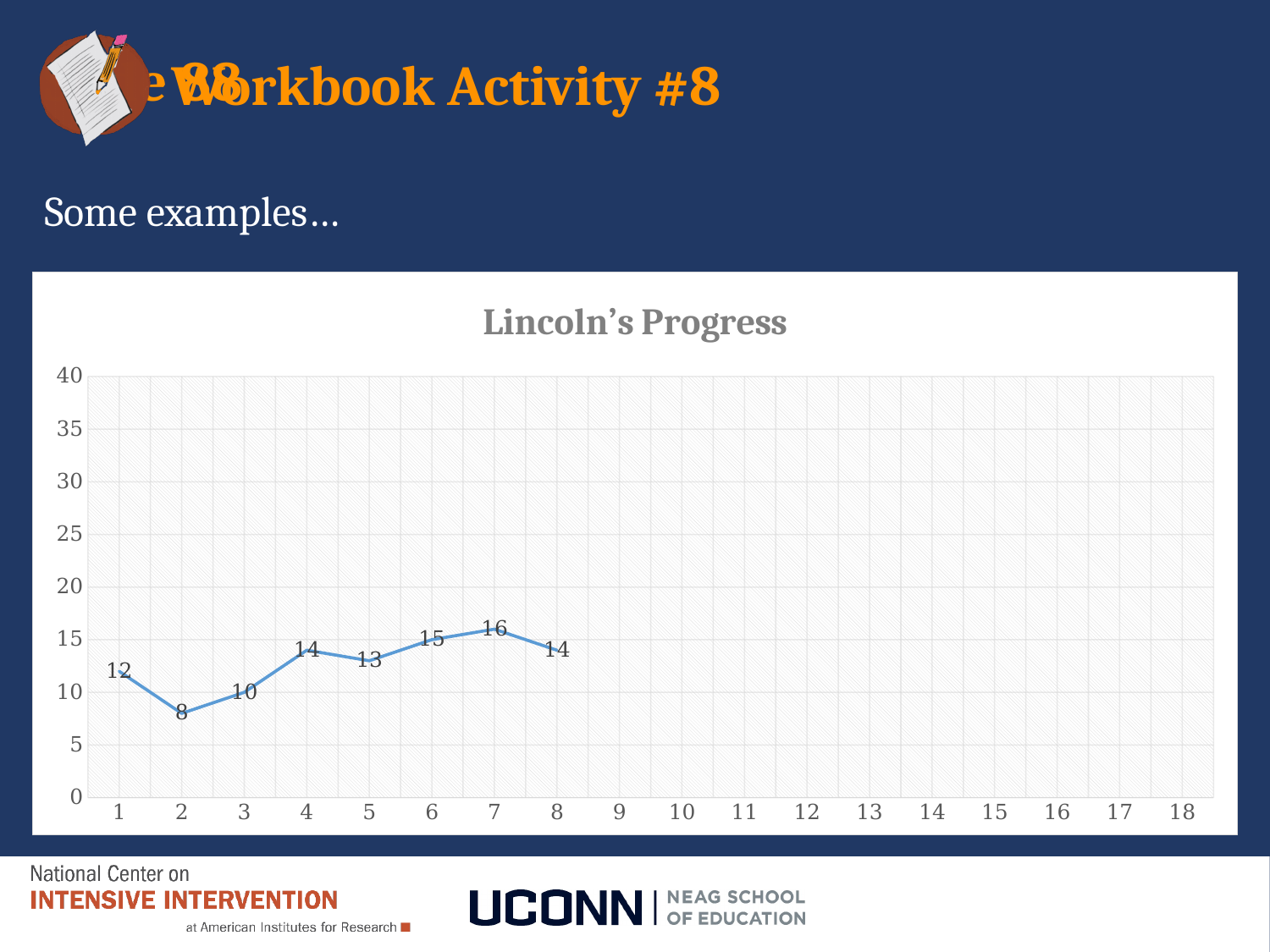
Is the value at point 8 greater or less than 20? less At which x-axis point is the value highest? 7 What is the value at point 1 in Lincoln's Progress? 12 Which is larger, the value at point 4 or the value at point 5? point 4 How many data points are plotted on the line? 8 What is the highest value shown on the y axis? 40 What is the value at point 3 in Lincoln's Progress? 10 What kind of chart is shown on the slide? line chart At which x-axis point is the value lowest? 2 What is the title of the chart? Lincoln's Progress What is the difference between the values at point 7 and point 2? 8 What is the value at point 7 in Lincoln's Progress? 16